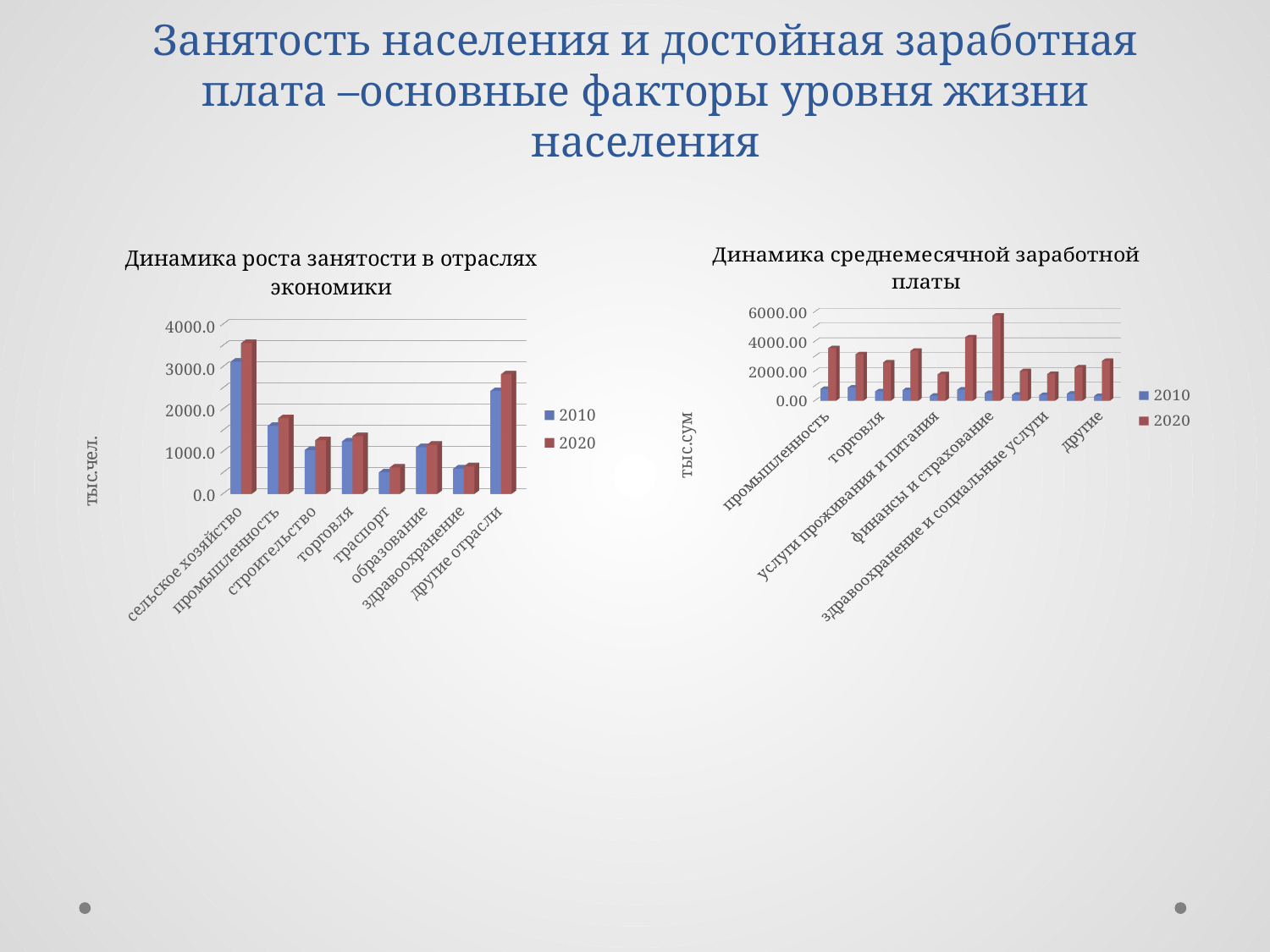
On the chart titled 'Динамика роста занятости в отраслях экономики', is the 2020 value for 'траспорт' greater or less than 1000.0? less On the chart titled 'Динамика роста занятости в отраслях экономики', which is larger for 2020: 'сельское хозяйство' or 'другие отрасли'? сельское хозяйство On the chart titled 'Динамика среднемесячной заработной платы', is the 2020 value for 'финансы и страхование' greater or less than 4000.00? greater On the chart titled 'Динамика среднемесячной заработной платы', which category has the highest value for 2020? финансы и страхование On the chart titled 'Динамика среднемесячной заработной платы', how many categories are plotted along the x axis? 11 On the chart titled 'Динамика роста занятости в отраслях экономики', what kind of chart is shown? bar chart On the chart titled 'Динамика роста занятости в отраслях экономики', how many categories are plotted along the x axis? 8 On the chart titled 'Динамика среднемесячной заработной платы', what unit is shown on the vertical axis label? тыс.сум On the chart titled 'Динамика роста занятости в отраслях экономики', is the 2020 value for 'другие отрасли' greater or less than 2000.0? greater On the chart titled 'Динамика среднемесячной заработной платы', which is larger for 2020: 'промышленность' or 'здравоохранение и социальные услуги'? промышленность On the chart titled 'Динамика роста занятости в отраслях экономики', which category has the highest value for 2020? сельское хозяйство On the chart titled 'Динамика роста занятости в отраслях экономики', how many series does the legend list? 2